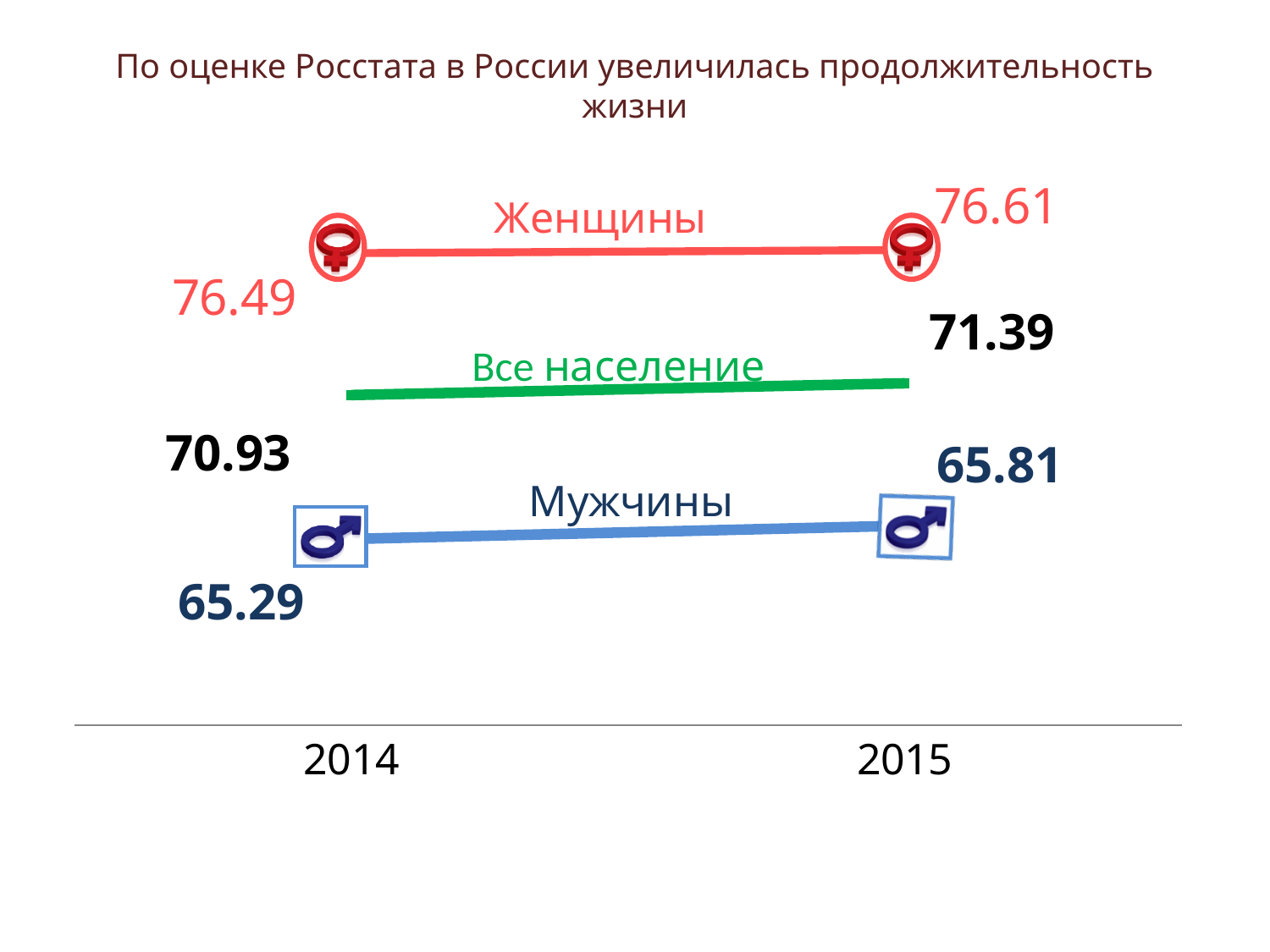
Which series has the lowest value in 2014? Мужчины How many series are plotted on the chart? 3 What is the value for Мужчины (men) in 2014? 65.29 Which series has the highest value in 2015? Женщины By how much did the value for Мужчины (men) increase from 2014 to 2015? 0.52 Which is larger: the Все население value in 2015 or the Женщины value in 2014? Женщины value in 2014 (76.49) What is the life expectancy value for Женщины (women) in 2014? 76.49 What is the difference between the Женщины and Мужчины values in 2015? 10.80 What is the life expectancy value for Женщины (women) in 2015? 76.61 Do the values for Все население rise or fall from 2014 to 2015? rise What is the value for Все население (all population) in 2015? 71.39 How many years are shown on the x axis? 2